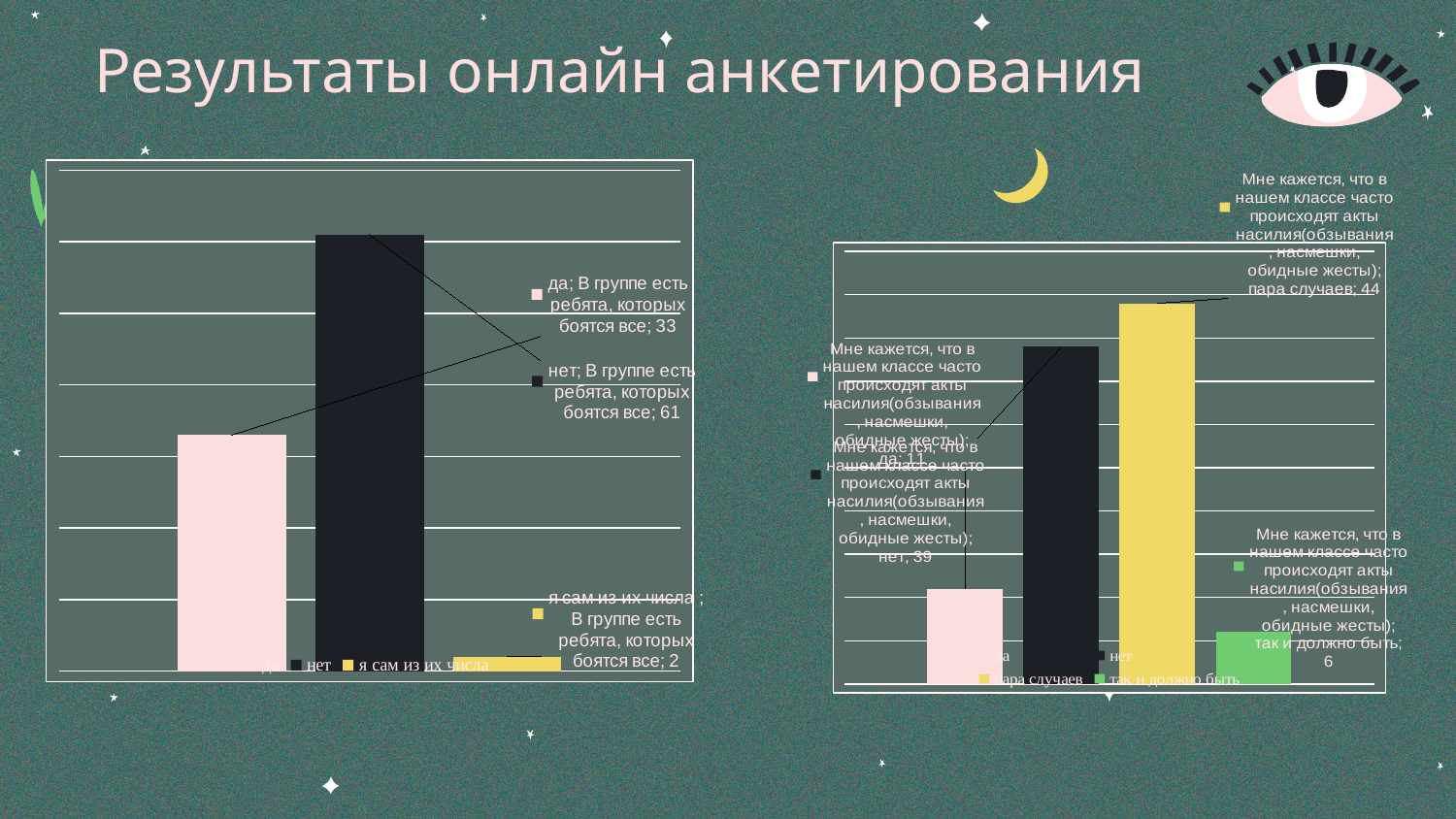
What type of chart is the right chart? bar chart In the right chart, what is the value for "да"? 11 In the left chart, what is the value for "да"? 33 In the right chart, what is the value for "пара случаев"? 44 In the left chart, how many categories are plotted? 3 In the left chart, what is the value for "нет"? 61 In the left chart, what is the value for "я сам из их числа"? 2 In the right chart, which category has the lowest value? так и должно быть In the right chart, what is the value for "нет"? 39 In the left chart, which category has the highest value? нет In the right chart, which is larger, the value for "да" or the value for "так и должно быть"? да In the left chart, what is the difference between the values for "нет" and "да"? 28